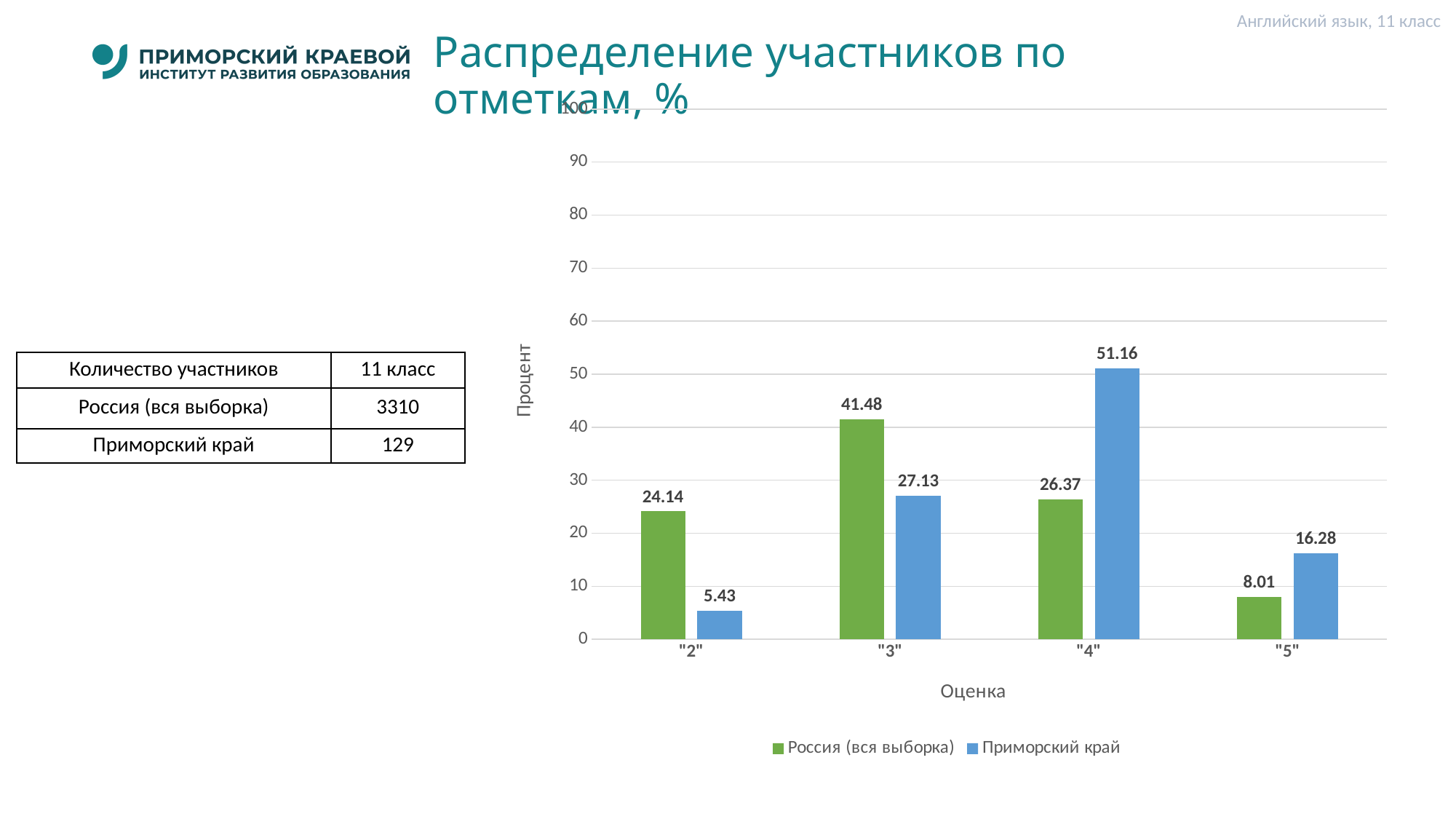
What is the value for Приморский край at grade "2"? 5.43 What is the value for Приморский край at grade "4"? 51.16 What is the value for Россия (вся выборка) at grade "5"? 8.01 What is the difference between the Приморский край and Россия (вся выборка) values at grade "4"? 24.79 What is the label of the y axis? Процент At grade "3", which series has the larger value: Россия (вся выборка) or Приморский край? Россия (вся выборка) What kind of chart is shown on the slide? Bar chart For which grade is the Приморский край value highest? "4" What is the value for Россия (вся выборка) at grade "3"? 41.48 How many grade categories are shown on the x axis? 4 How many series does the legend list? 2 For which grade is the Россия (вся выборка) value lowest? "5"